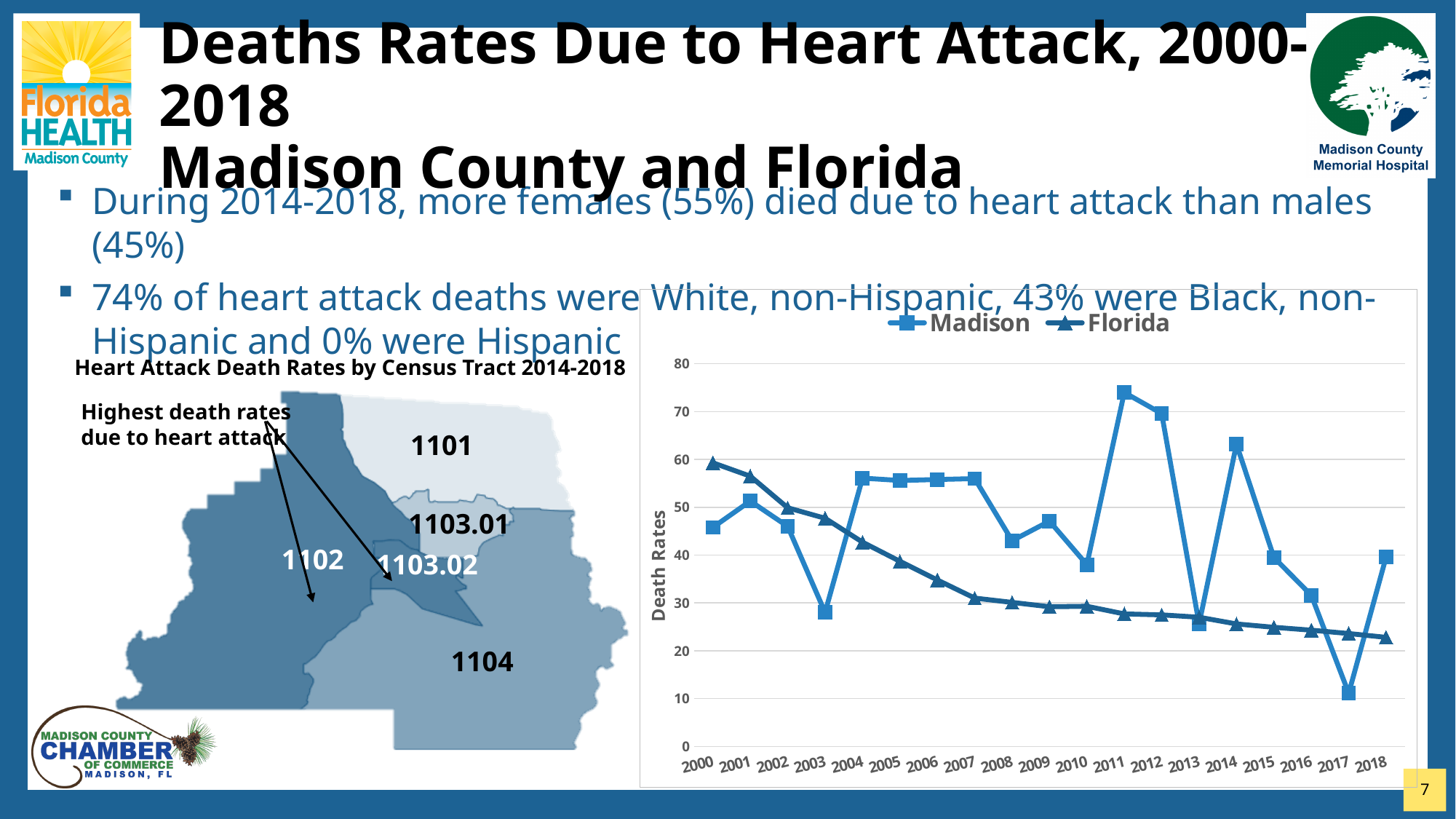
In the line chart, in which year does the Madison series reach its lowest value? 2017 In the line chart, is the Florida value for 2018 greater or less than 30? less In the line chart, is the Madison value for 2017 greater or less than 20? less In the line chart, which series has the higher value in 2000, Madison or Florida? Florida How many series does the legend of the line chart list? 2 In the line chart, is the Madison value for 2011 greater or less than 70? greater How many years are plotted along the x axis of the line chart? 19 In the line chart, does the Florida series generally rise or fall from 2000 to 2018? fall What is the label on the vertical axis of the line chart? Death Rates What kind of chart is shown on the right side of the slide? line chart Which two series are listed in the legend of the line chart? Madison and Florida In the line chart, in which year does the Madison series reach its highest value? 2011